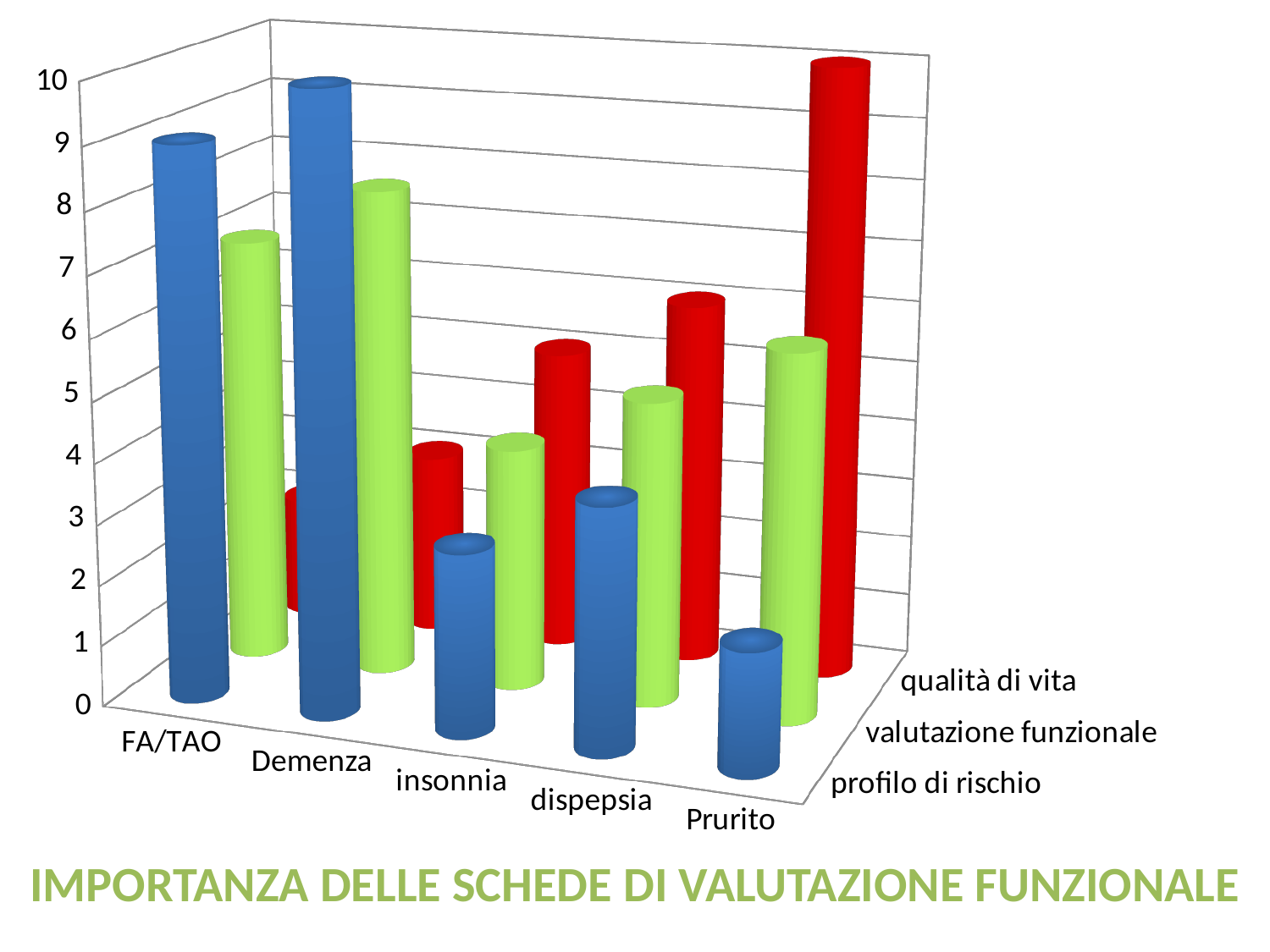
Which category has the highest value for the 'profilo di rischio' series? Demenza Do the 'qualità di vita' values rise or fall moving from FA/TAO to Prurito along the x axis? rise For Prurito, which is larger: 'qualità di vita' or 'profilo di rischio'? qualità di vita Which category has the highest value for the 'qualità di vita' series? Prurito What is the title shown below the chart? IMPORTANZA DELLE SCHEDE DI VALUTAZIONE FUNZIONALE What kind of chart is shown on the slide? bar chart How many categories are shown along the x axis of the chart? 5 Is the 'qualità di vita' value for FA/TAO greater or less than 5? less Is the 'profilo di rischio' value for Prurito greater or less than 5? less Which category has the lowest value for the 'qualità di vita' series? FA/TAO How many series does the chart show? 3 Is the 'profilo di rischio' value for FA/TAO greater or less than 5? greater